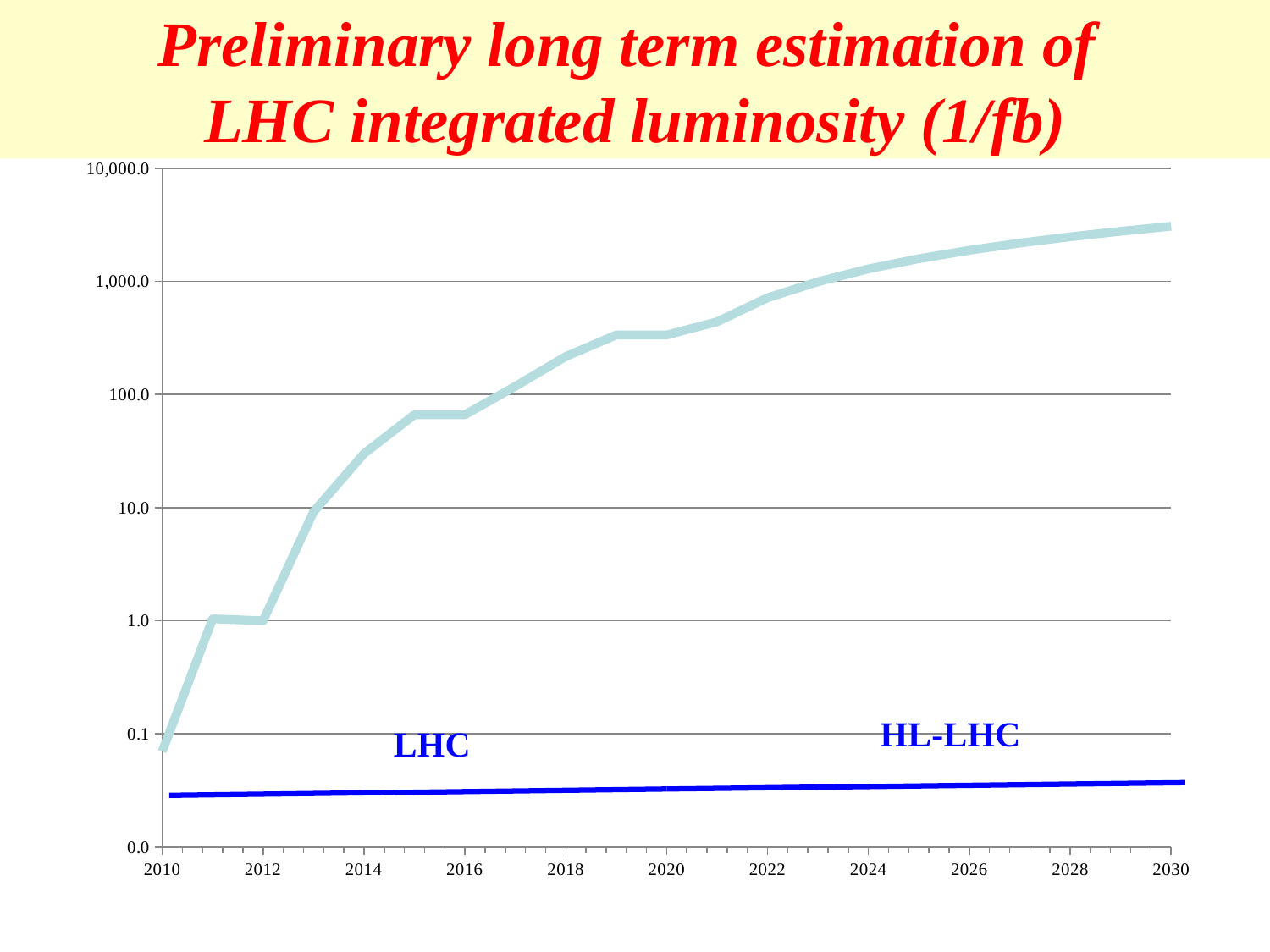
What kind of chart is shown on the slide? line chart Is the value for 2018 greater or less than 100.0? greater Is the value for 2014 greater or less than 10.0? greater Is the value for 2020 greater or less than 1,000.0? less Does the integrated luminosity rise or fall from 2010 to 2030? rise Which is larger, the value for 2022 or the value for 2012? 2022 What are the two labels written along the blue line at the bottom of the chart? LHC and HL-LHC Which year has the lowest integrated luminosity? 2010 Which year has the highest integrated luminosity? 2030